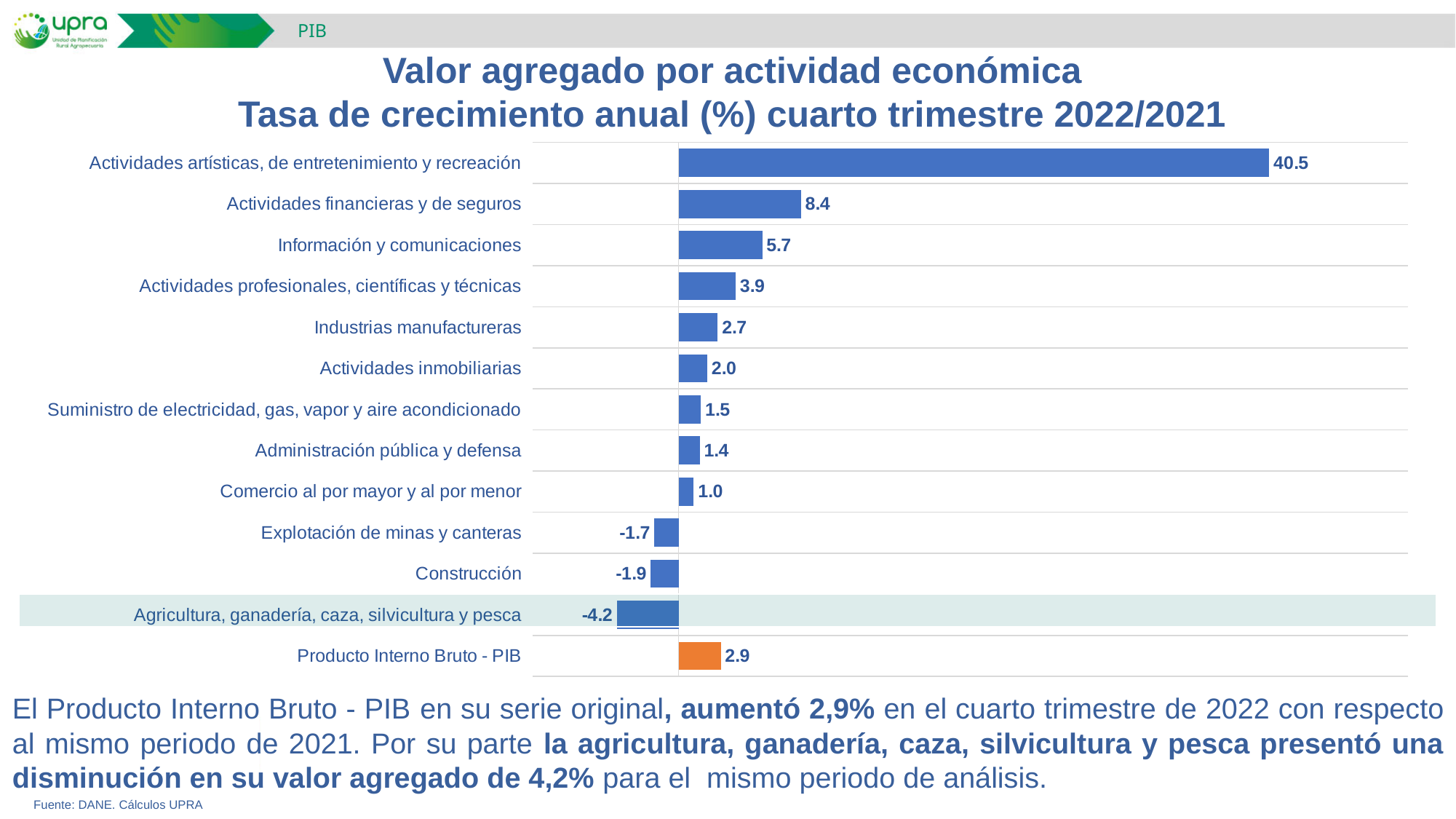
What kind of chart is shown on the slide? Bar chart What is the value for Actividades artísticas, de entretenimiento y recreación? 40.5 What is the value for Construcción? -1.9 How many categories are shown in the chart? 13 Which bar is shown in orange rather than blue? Producto Interno Bruto - PIB What is the value for Agricultura, ganadería, caza, silvicultura y pesca? -4.2 Which is larger, the value for Industrias manufacturereras or the value for Actividades inmobiliarias? Industrias manufactureras What is the value for Producto Interno Bruto - PIB? 2.9 How many categories have negative values? 3 What is the difference between the values for Actividades financieras y de seguros and Información y comunicaciones? 2.7 Which category has the highest value? Actividades artísticas, de entretenimiento y recreación Which category has the lowest value? Agricultura, ganadería, caza, silvicultura y pesca